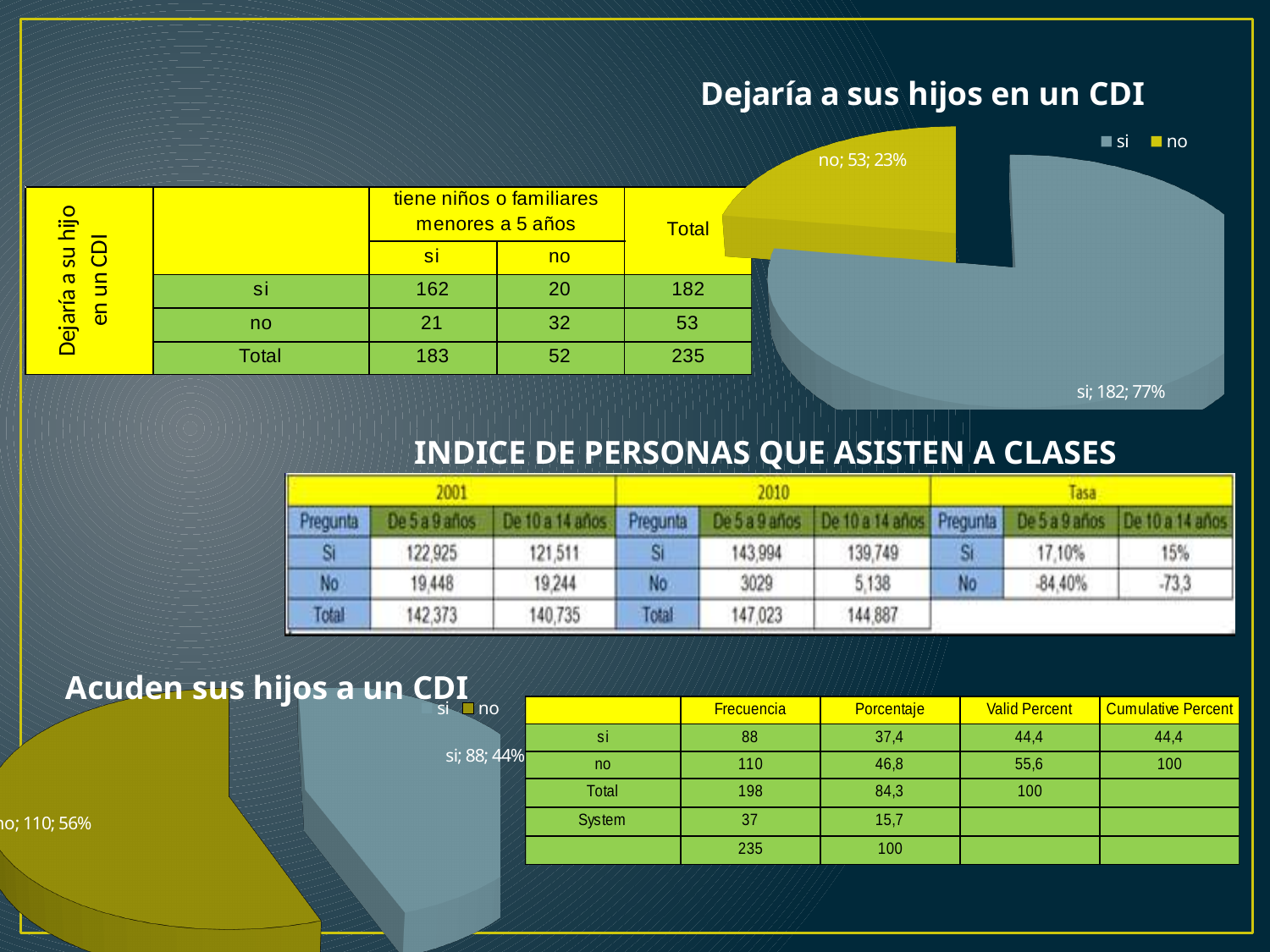
How many entries does the legend of the 'Acuden sus hijos a un CDI' chart list? 2 In the 'Dejaría a sus hijos en un CDI' chart, what value is shown for 'no'? 53 In the 'Acuden sus hijos a un CDI' chart, what value is shown for 'si'? 88 In the 'Acuden sus hijos a un CDI' chart, what value is shown for 'no'? 110 In the 'Acuden sus hijos a un CDI' chart, what percentage share does the 'no' slice have? 56% In the 'Dejaría a sus hijos en un CDI' chart, what is the difference between the 'si' and 'no' values? 129 In the 'Acuden sus hijos a un CDI' chart, which is larger, 'si' or 'no'? no In the 'Dejaría a sus hijos en un CDI' chart, what value is shown for 'si'? 182 In the 'Dejaría a sus hijos en un CDI' chart, what percentage share does the 'no' slice have? 23% What kind of chart is 'Dejaría a sus hijos en un CDI'? pie chart In the 'Dejaría a sus hijos en un CDI' chart, what percentage share does the 'si' slice have? 77% In the 'Dejaría a sus hijos en un CDI' chart, which category is the largest? si